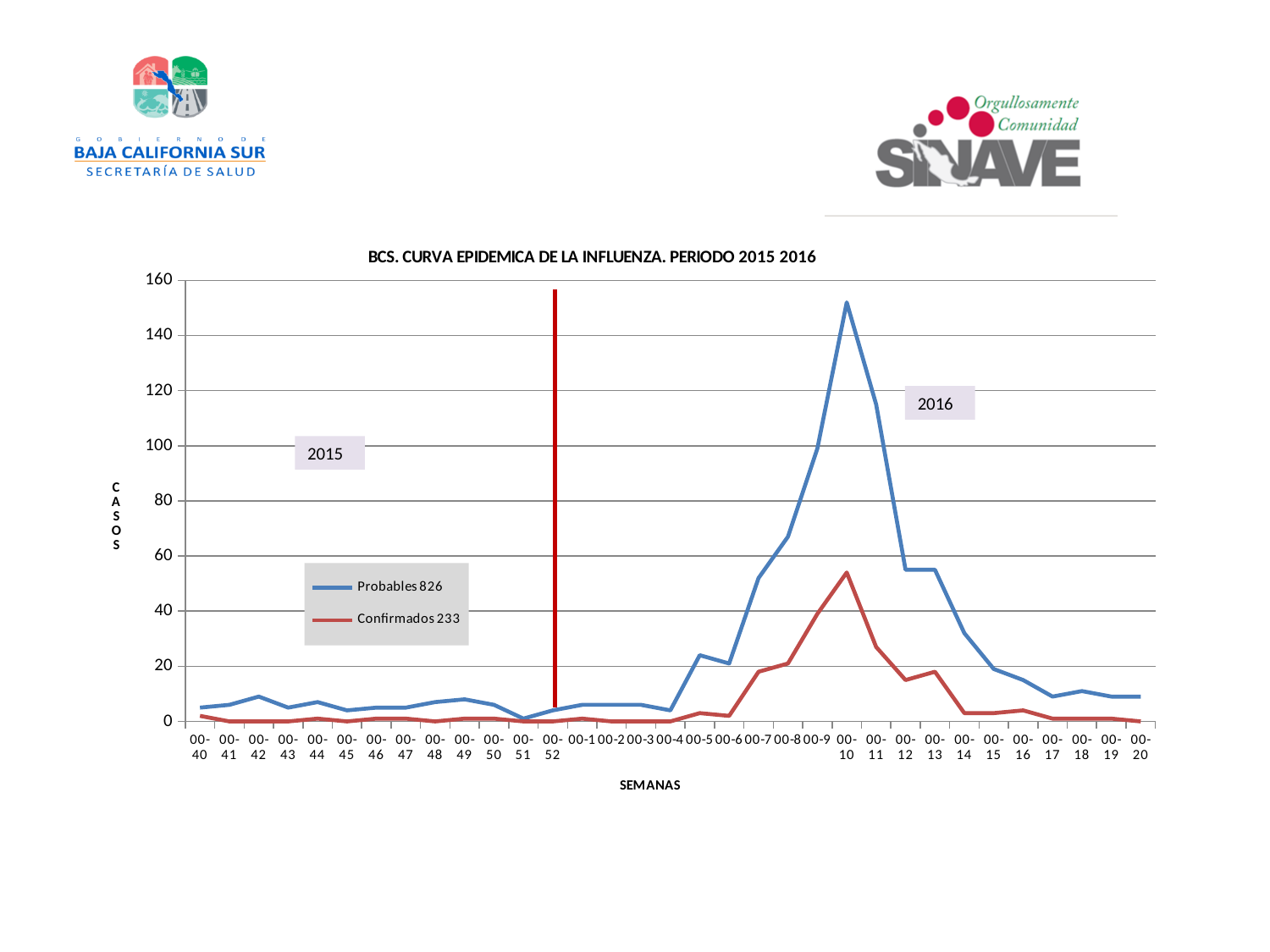
Which series has the larger value in week 00-10, Probables or Confirmados? Probables Do the Probables values rise or fall from week 00-10 to week 00-20? fall Is the value of Probables in week 00-10 greater or less than 140? greater What is the title of the chart? BCS. CURVA EPIDEMICA DE LA INFLUENZA. PERIODO 2015 2016 Is the value of Probables in week 00-12 greater or less than 40? greater How many weeks are shown on the x axis? 33 In which week does the Probables series reach its highest value? 00-10 In which week does the Confirmados series reach its highest value? 00-10 Is the value of Confirmados in week 00-10 greater or less than 60? less What kind of chart is shown on the slide? line chart What are the two legend entries of the chart? Probables 826 and Confirmados 233 How many series does the legend list? 2